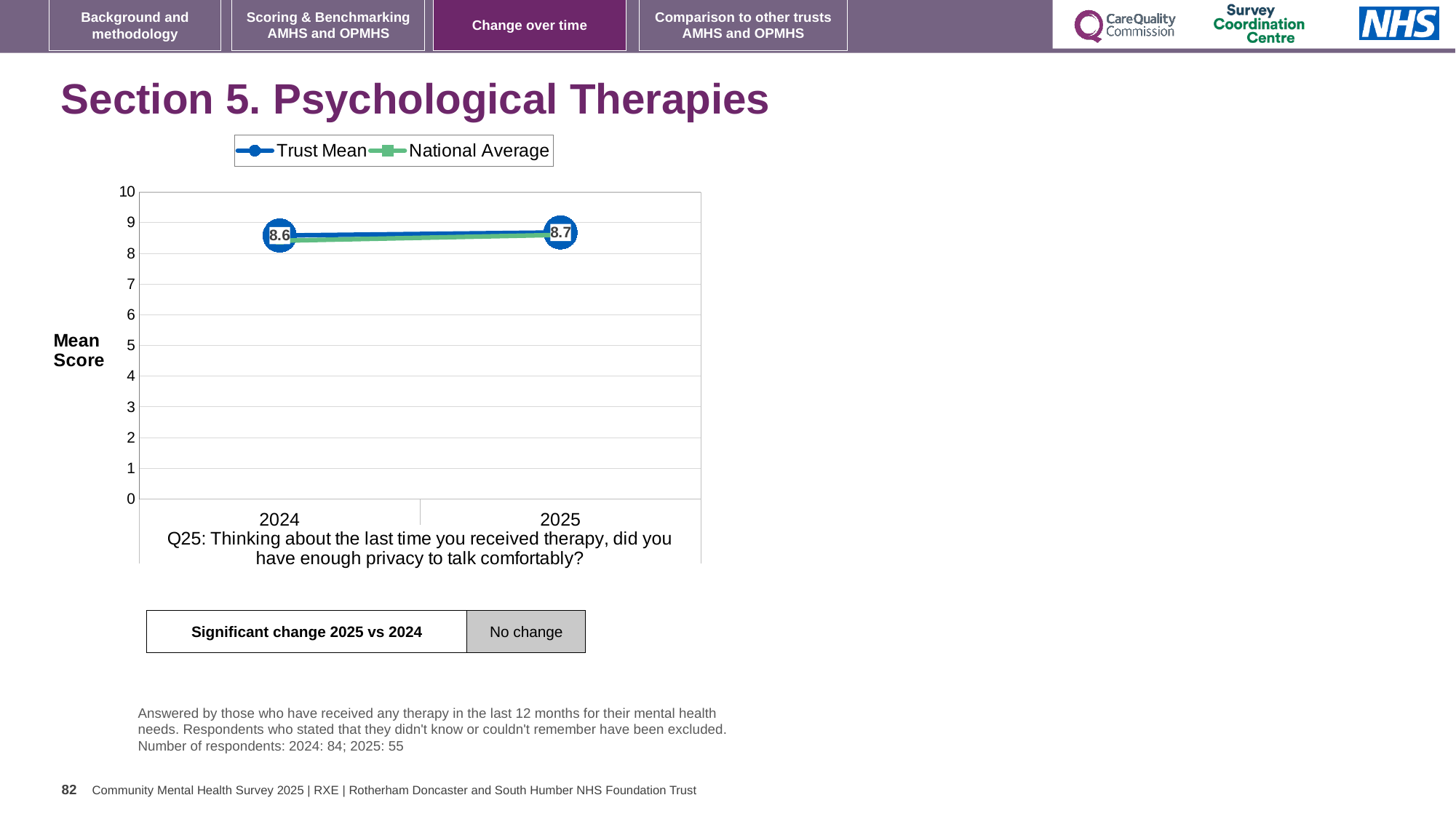
Does the Trust Mean rise or fall from 2024 to 2025? rise What is the Trust Mean value for 2025? 8.7 What kind of chart is shown on the slide? line chart What is the Trust Mean value for 2024? 8.6 Is the Trust Mean for 2024 greater or less than 8? greater What is the difference between the Trust Mean in 2025 and in 2024? 0.1 Which year has the higher Trust Mean, 2024 or 2025? 2025 What is the label of the y axis of the chart? Mean Score Is the National Average for 2025 greater or less than 8? greater How many years are shown on the x axis of the chart? 2 How many series does the chart legend list? 2 Which series in the legend is shown in green? National Average